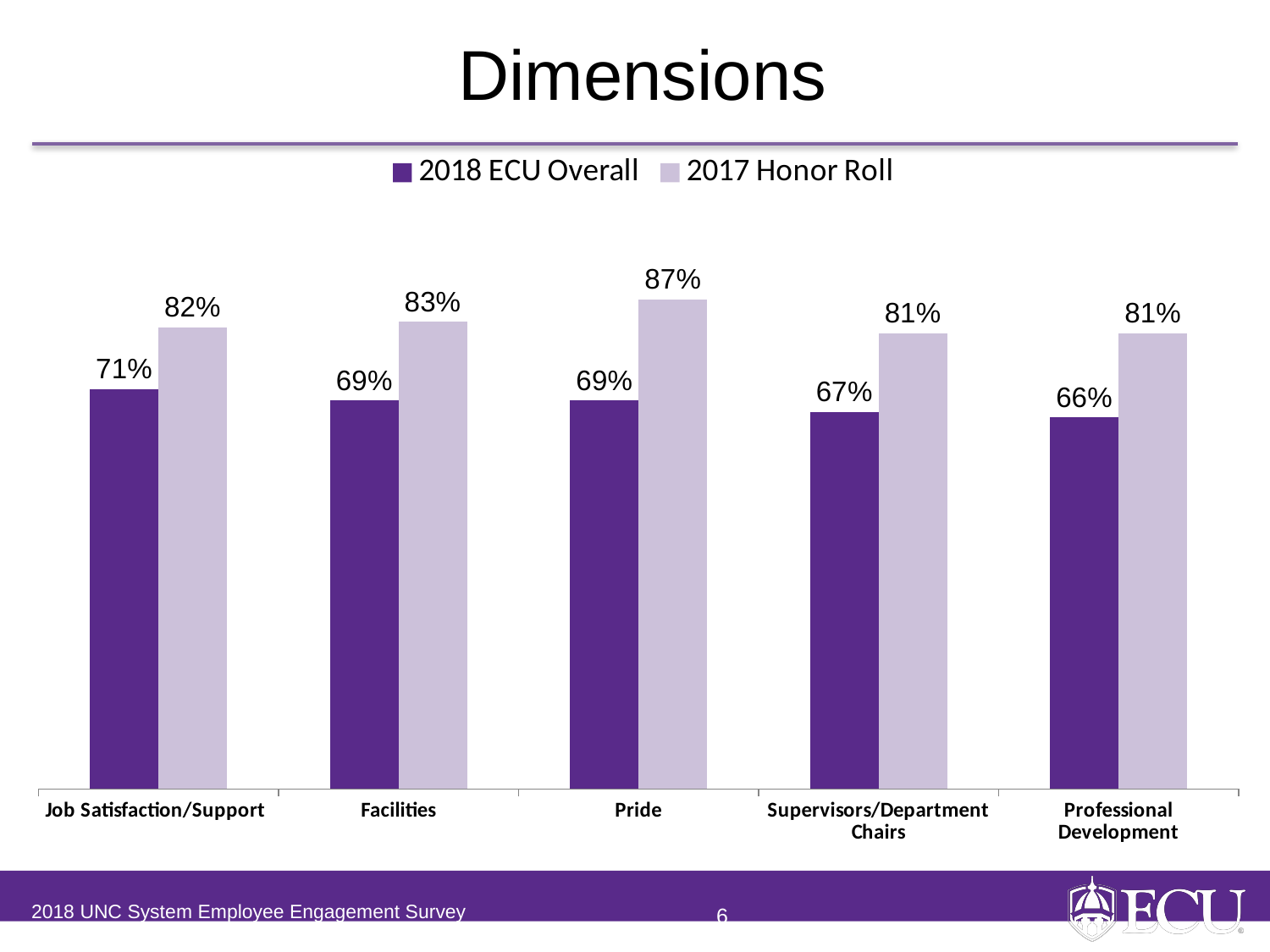
What is the 2017 Honor Roll value for Facilities? 83% Which category has the highest 2017 Honor Roll value? Pride Which category has the lowest 2018 ECU Overall value? Professional Development How many series does the legend list? 2 What is the difference between the 2017 Honor Roll and 2018 ECU Overall values for Pride? 18% What is the 2018 ECU Overall value for Professional Development? 66% What is the difference between the 2017 Honor Roll and 2018 ECU Overall values for Job Satisfaction/Support? 11% What is the 2018 ECU Overall value for Job Satisfaction/Support? 71% What kind of chart is shown on the slide? Bar chart Which is larger for Supervisors/Department Chairs: the 2018 ECU Overall value or the 2017 Honor Roll value? 2017 Honor Roll How many categories are shown on the x axis? 5 What is the 2017 Honor Roll value for Pride? 87%